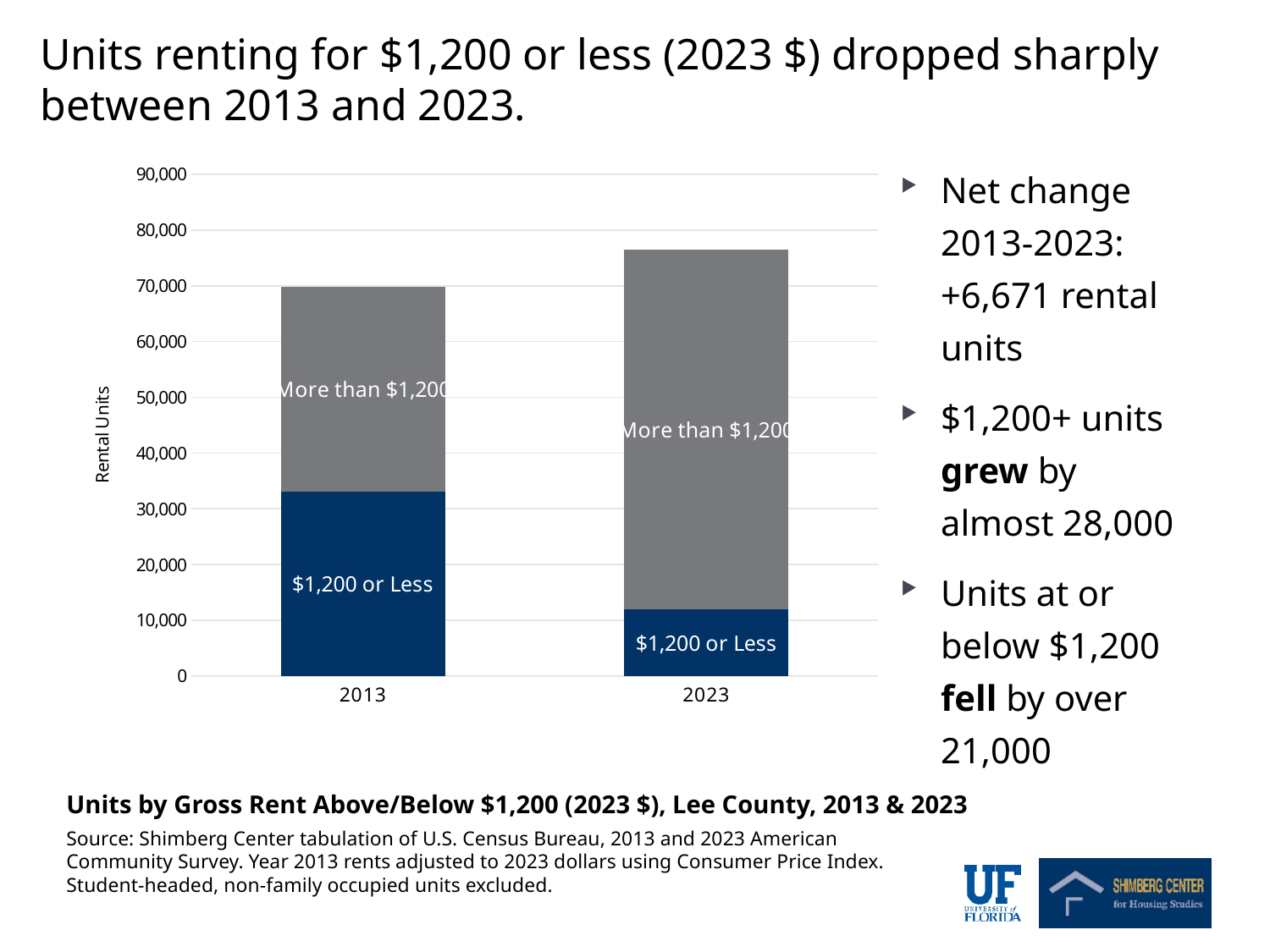
Is the value for the "$1,200 or Less" segment in 2023 greater or less than 20,000? less Which year has the taller total bar, 2013 or 2023? 2023 How many rent segments make up each stacked bar in the chart? 2 Does the "$1,200 or Less" segment rise or fall from 2013 to 2023? fall Is the value for the "$1,200 or Less" segment in 2013 greater or less than 30,000? greater How many years (categories) are shown on the x axis of the chart? 2 Is the total height of the 2013 bar greater or less than 80,000? less What kind of chart is shown on the slide? Stacked bar chart What is the label on the vertical axis of the chart? Rental Units In 2023, which segment is larger: "$1,200 or Less" or "More than $1,200"? More than $1,200 Which year has the larger "$1,200 or Less" segment, 2013 or 2023? 2013